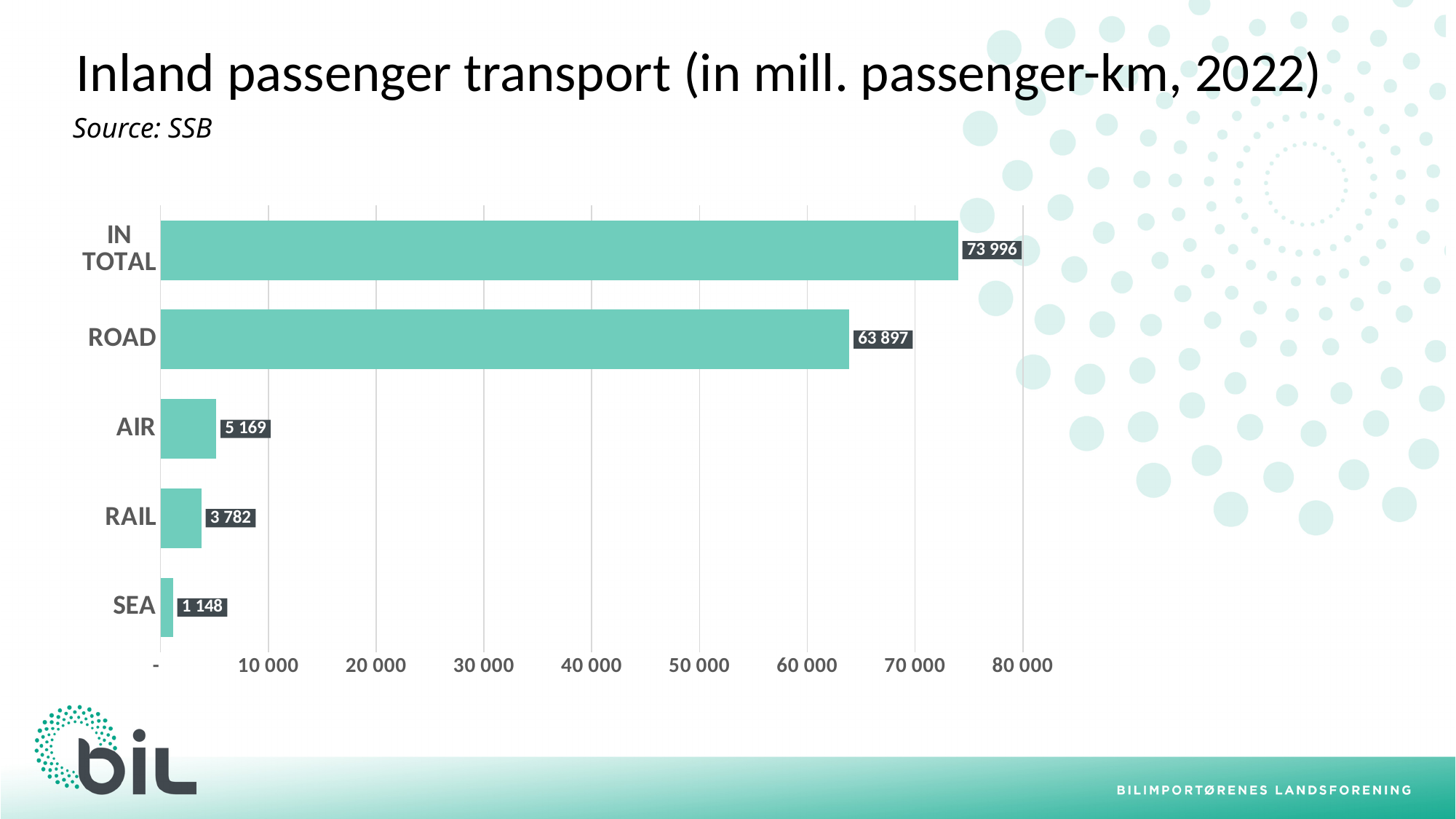
Is the value for ROAD greater or less than 60 000? greater What is the value for ROAD? 63 897 How many bars are shown in the chart? 5 What is the difference between the values for AIR and RAIL? 1 387 What is the value for SEA? 1 148 What is the value for RAIL? 3 782 What is the value for AIR? 5 169 What is the value for IN TOTAL? 73 996 Excluding the IN TOTAL bar, which transport mode has the highest value? ROAD What kind of chart is shown on the slide? Bar chart Which is larger, the value for RAIL or the value for SEA? RAIL Which category has the lowest value? SEA